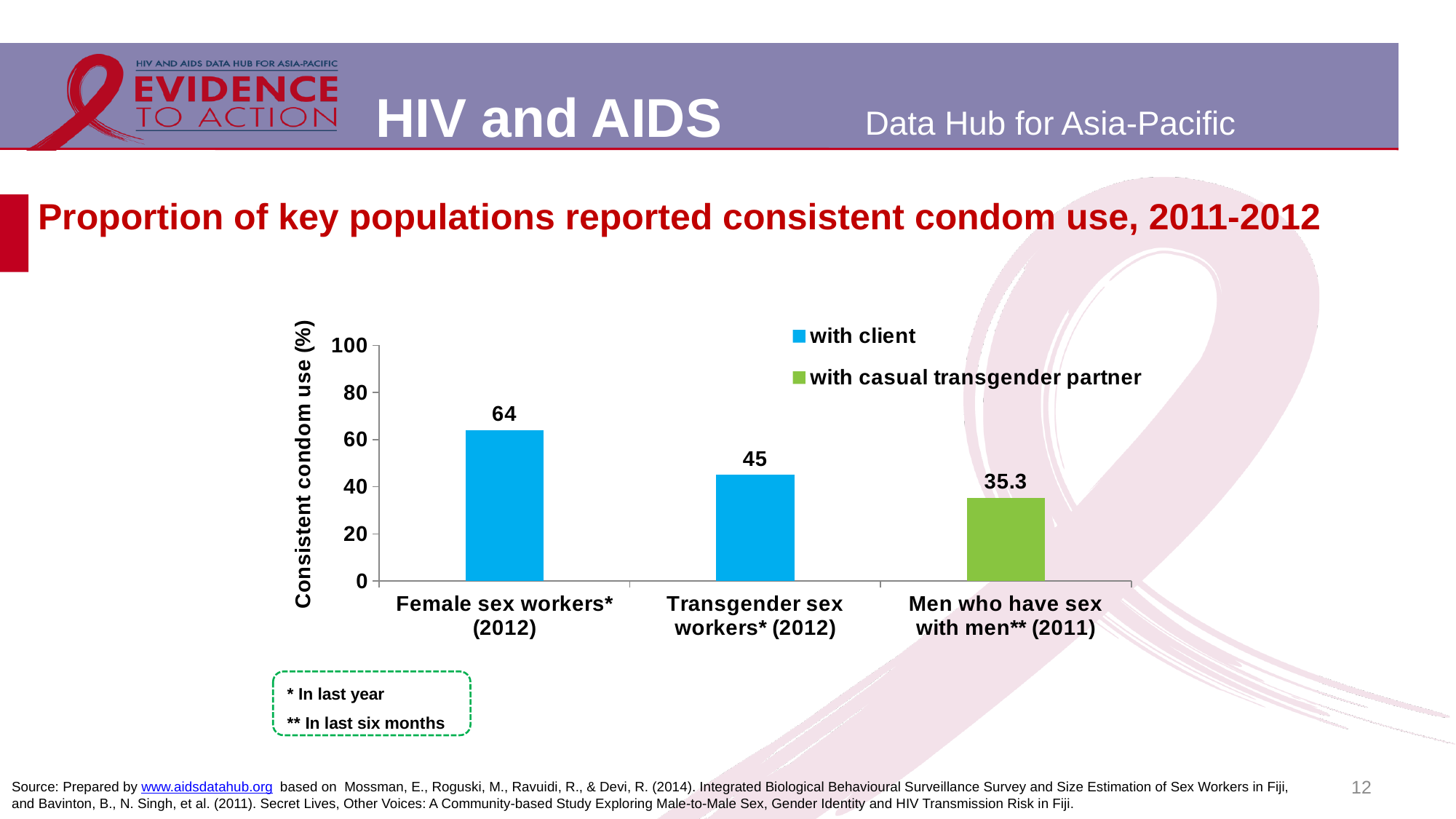
How many series does the legend list? 2 Which category has the highest value? Female sex workers* (2012) What is the value for Transgender sex workers* (2012)? 45 Which series does the bar for Men who have sex with men** (2011) belong to? with casual transgender partner What is the difference between the values for Female sex workers* (2012) and Transgender sex workers* (2012)? 19 What kind of chart is shown on the slide? bar chart What is the difference between the values for Transgender sex workers* (2012) and Men who have sex with men** (2011)? 9.7 Which category has the lowest value? Men who have sex with men** (2011) How many categories are shown on the x axis? 3 What is the value for Female sex workers* (2012)? 64 Which is larger, the value for Transgender sex workers* (2012) or the value for Men who have sex with men** (2011)? Transgender sex workers* (2012) What is the value for Men who have sex with men** (2011)? 35.3